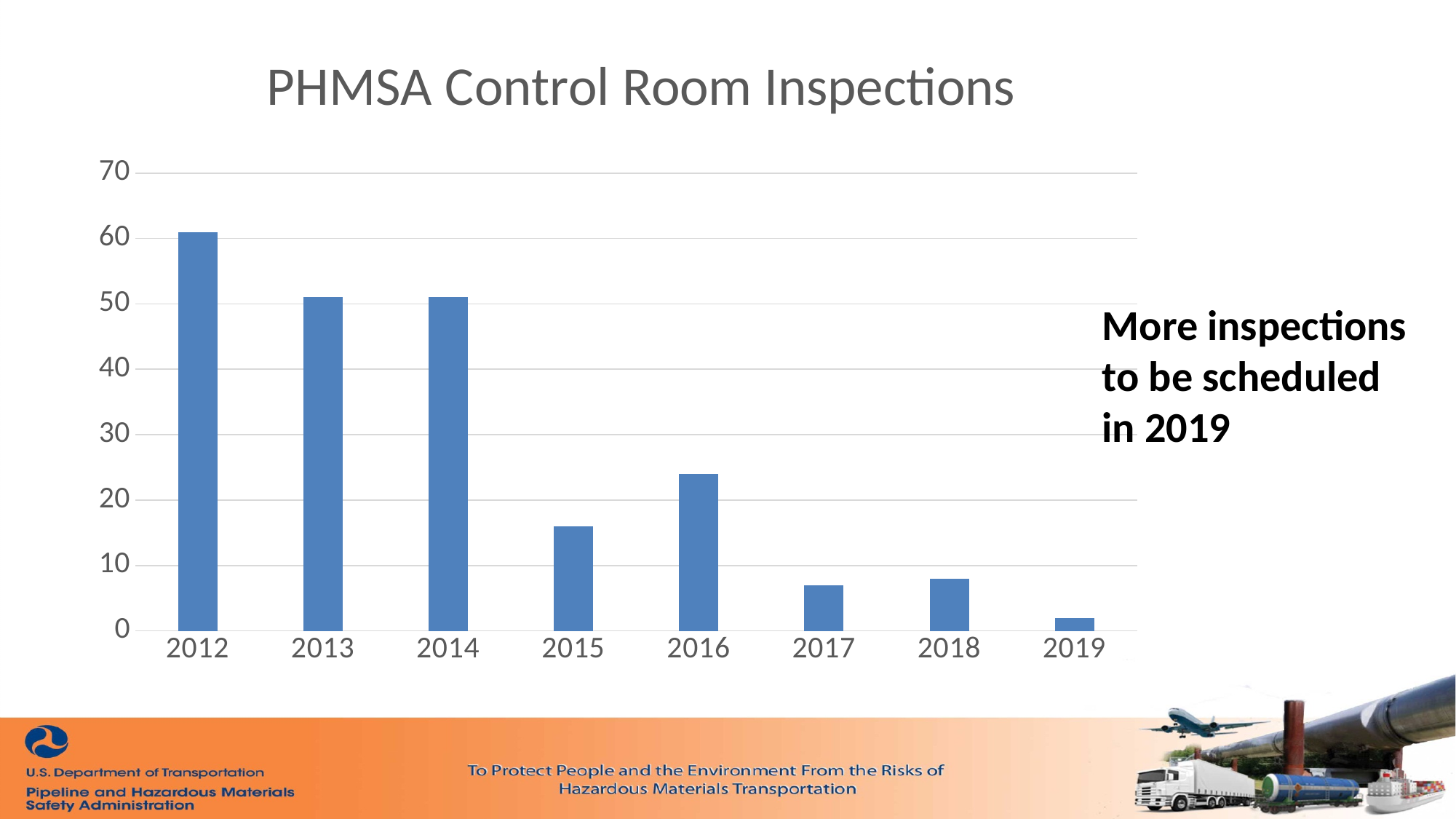
Is the value for 2015 greater or less than 20? less Do the inspection counts generally rise or fall from 2012 to 2019? fall Is the value for 2012 greater or less than 50? greater Which year has the lowest number of inspections? 2019 What kind of chart is shown on the slide? bar chart Which year has more inspections, 2015 or 2016? 2016 How many years are shown on the x axis of the chart? 8 Is the value for 2016 greater or less than 20? greater What is the title of the chart? PHMSA Control Room Inspections Which year has the highest number of inspections? 2012